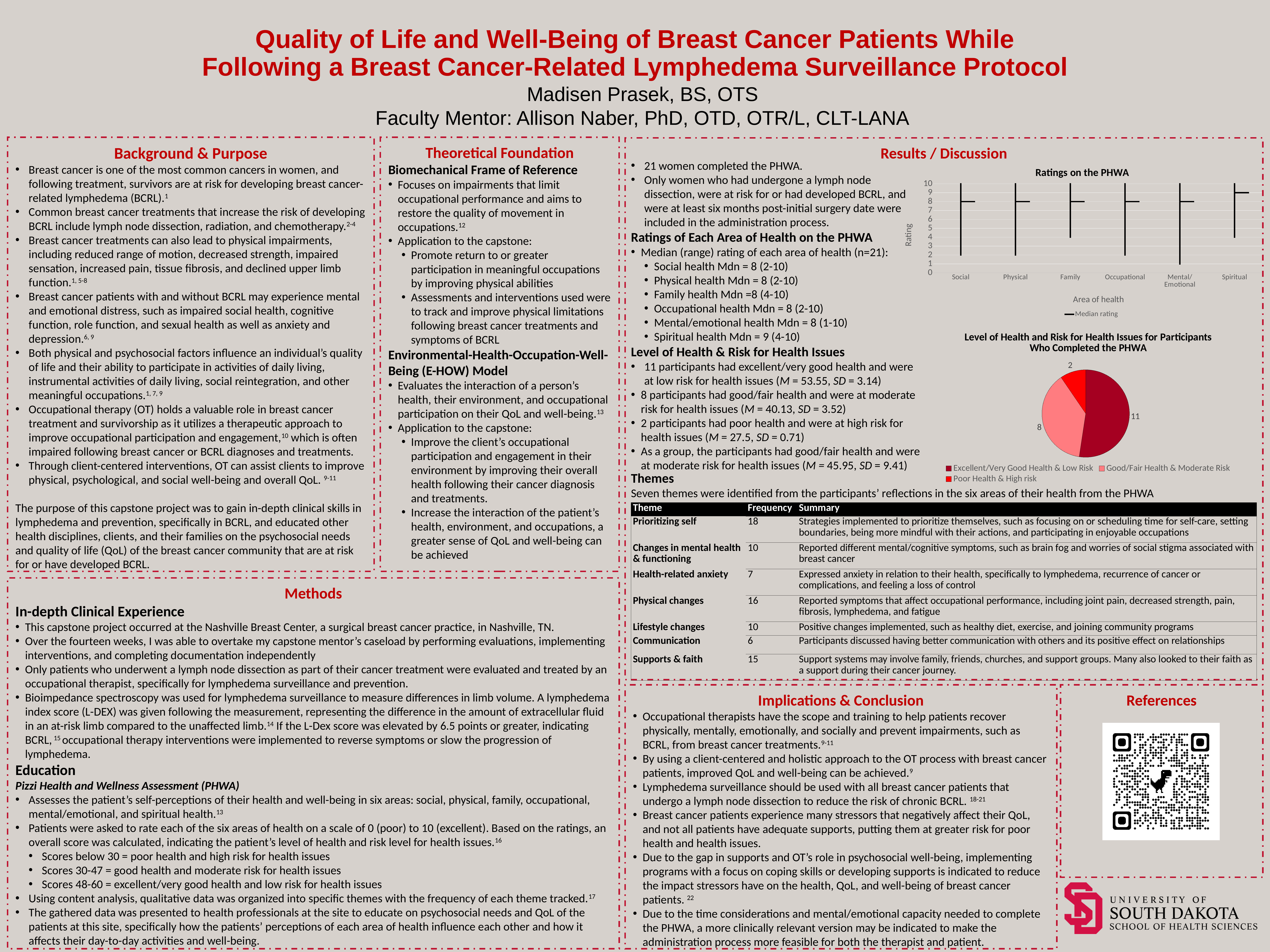
In the chart 'Ratings on the PHWA', what is the label of the x axis? Area of health In the chart 'Ratings on the PHWA', is the median rating for Spiritual greater or less than 5? greater In the chart 'Ratings on the PHWA', what is the label of the series shown in the legend? Median rating In the pie chart 'Level of Health and Risk for Health Issues for Participants Who Completed the PHWA', how many participants had good/fair health and moderate risk? 8 In the pie chart 'Level of Health and Risk for Health Issues for Participants Who Completed the PHWA', how many categories does the legend list? 3 In the chart 'Ratings on the PHWA', how many areas of health are shown on the x axis? 6 In the pie chart 'Level of Health and Risk for Health Issues for Participants Who Completed the PHWA', which category has the largest slice? Excellent/Very Good Health & Low Risk In the pie chart 'Level of Health and Risk for Health Issues for Participants Who Completed the PHWA', how many participants had poor health and high risk? 2 In the pie chart 'Level of Health and Risk for Health Issues for Participants Who Completed the PHWA', what is the total number of participants across all three slices? 21 In the pie chart 'Level of Health and Risk for Health Issues for Participants Who Completed the PHWA', which category has the smallest slice? Poor Health & High risk In the pie chart 'Level of Health and Risk for Health Issues for Participants Who Completed the PHWA', how many participants had excellent/very good health and low risk? 11 In the pie chart 'Level of Health and Risk for Health Issues for Participants Who Completed the PHWA', what is the difference between the number of participants with excellent/very good health and those with good/fair health? 3